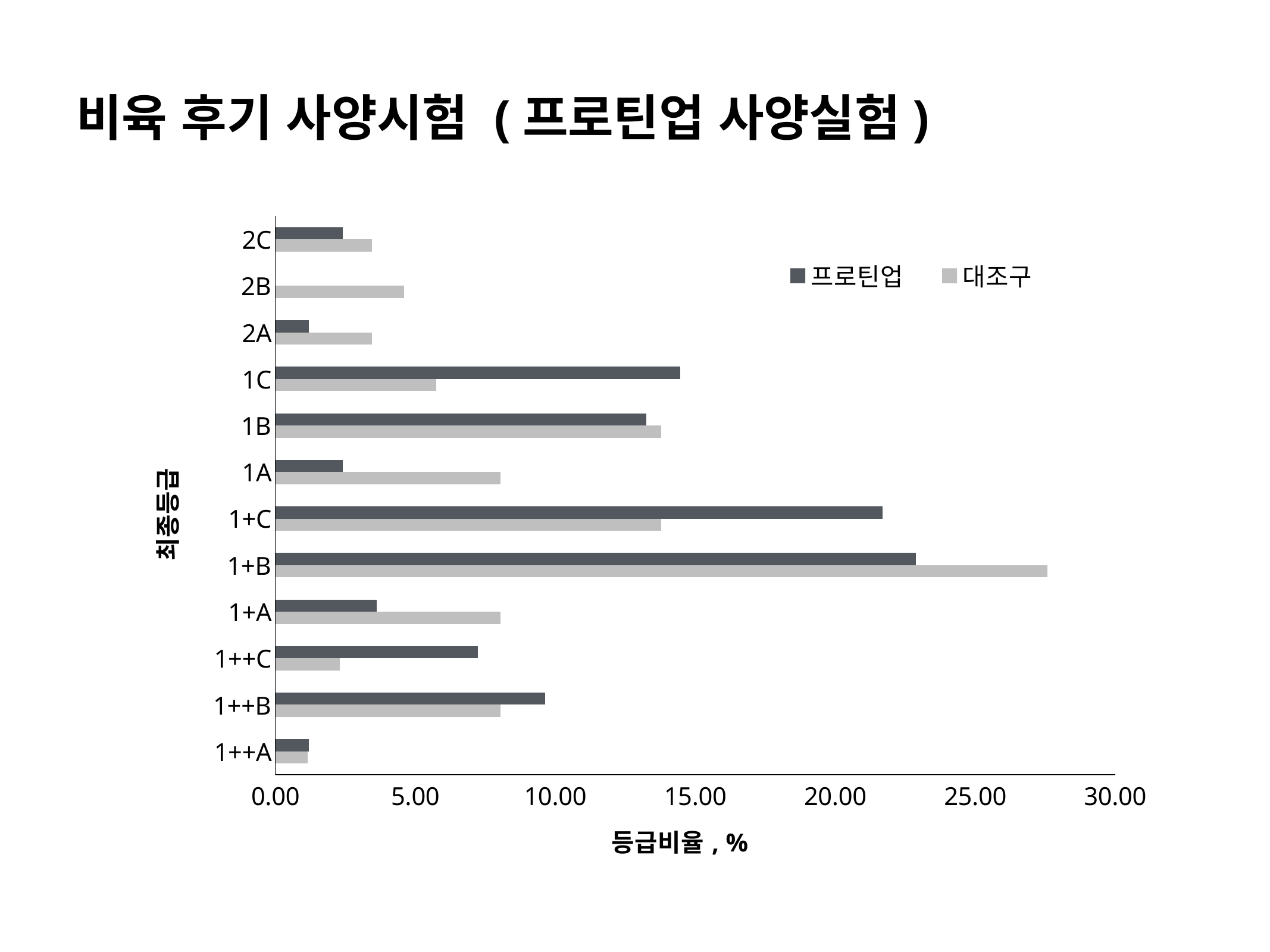
What kind of chart is shown on the slide? bar chart For grade 1C, which series has the larger value, 프로틴업 or 대조구? 프로틴업 For grade 1A, which series has the larger value, 프로틴업 or 대조구? 대조구 Is the 대조구 value for 1+B greater or less than 25.00? greater What is the title of the x axis? 등급비율 , % Which grade has the highest value for 프로틴업? 1+B Which grade has the lowest value for 대조구? 1++A How many series does the legend list? 2 How many grade categories are shown on the y axis? 12 Which grade has the highest value for 대조구? 1+B Is the 프로틴업 value for 1+C greater or less than 20.00? greater Is the 프로틴업 value for 1++C greater or less than 5.00? greater